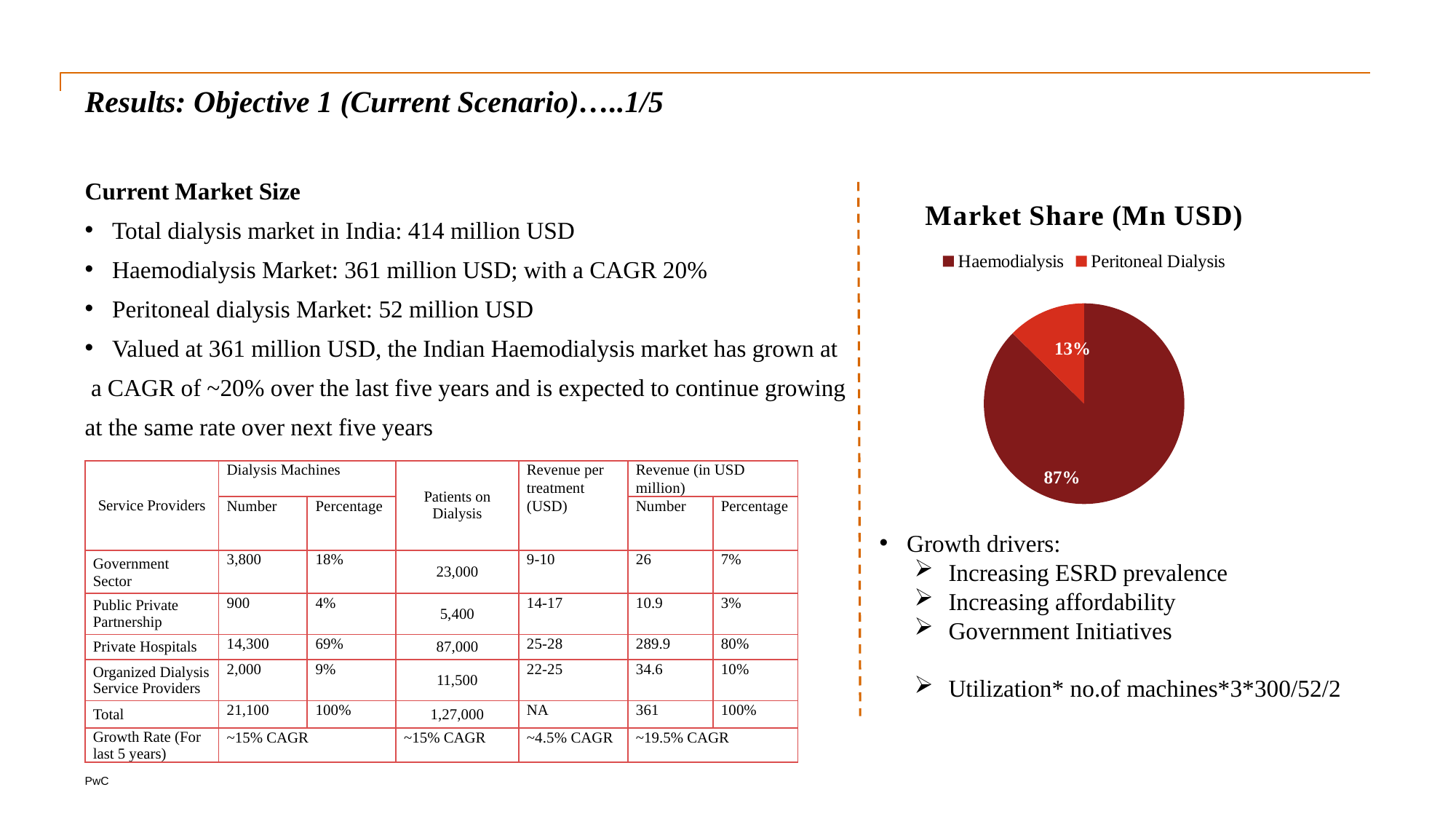
What share of the pie does Haemodialysis have? 87% What share of the pie does Peritoneal Dialysis have? 13% What is the difference in percentage points between the Haemodialysis and Peritoneal Dialysis slices? 74 How many slices does the pie chart have? 2 Which legend entry is shown in the darker red colour? Haemodialysis How many entries does the chart legend list? 2 What is the title of the chart? Market Share (Mn USD) Which slice of the pie is the largest? Haemodialysis What kind of chart is shown on the slide? pie chart Which slice of the pie is the smallest? Peritoneal Dialysis Which is larger, the Haemodialysis slice or the Peritoneal Dialysis slice? Haemodialysis